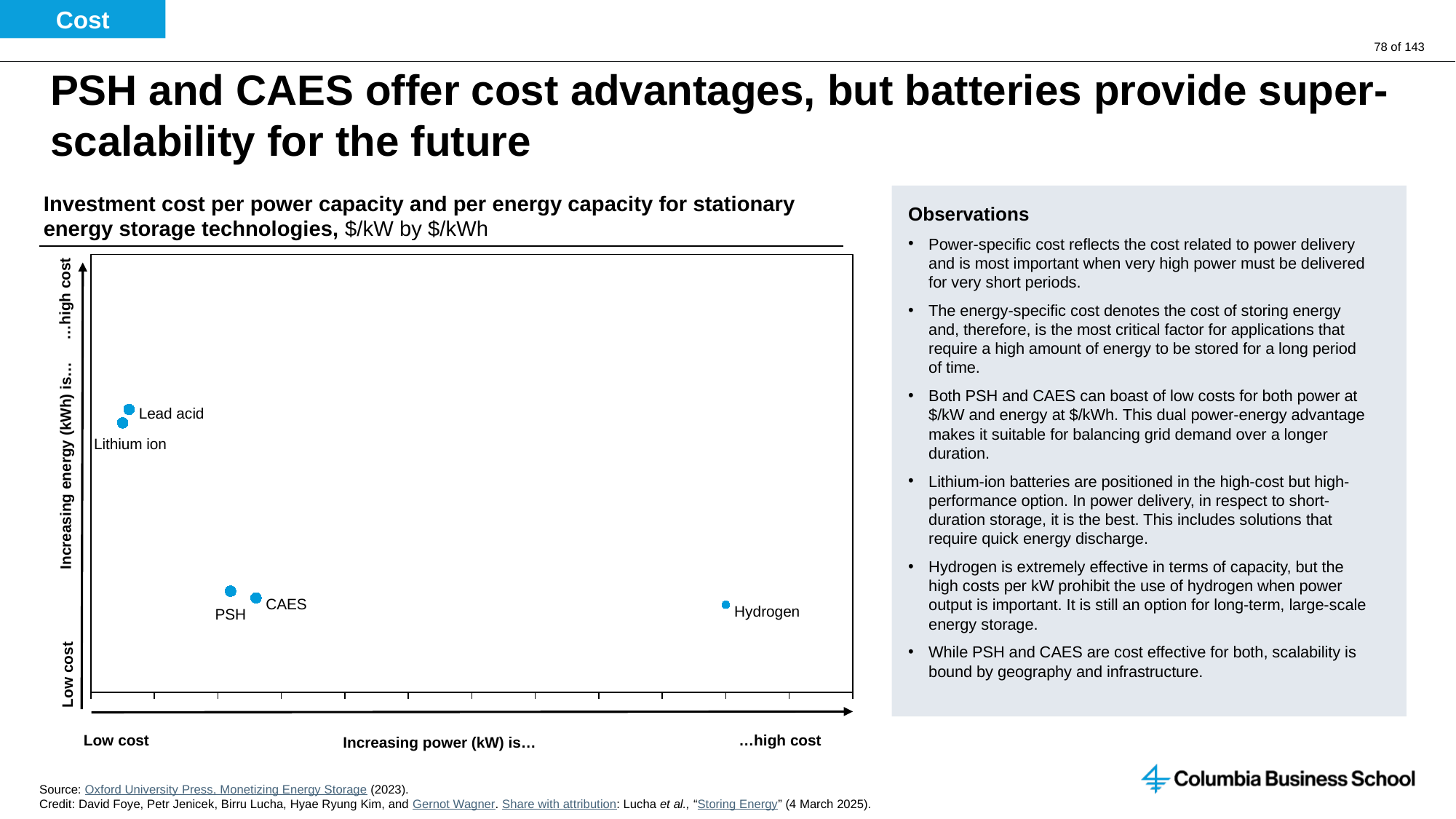
How many storage technologies are plotted on the chart? 5 Which technology is plotted furthest to the left, i.e. has the lowest power cost ($/kW)? Lithium ion Which has the higher energy cost ($/kWh) on the chart, Lithium ion or Hydrogen? Lithium ion Which has the higher power cost ($/kW) on the chart, Hydrogen or CAES? Hydrogen What quantity does the horizontal axis of the chart represent? Increasing power (kW) cost What units are given in the chart title for the two axes? $/kW by $/kWh Which has the higher energy cost ($/kWh) on the chart, Lead acid or PSH? Lead acid Which technology is plotted furthest to the right, i.e. has the highest power cost ($/kW)? Hydrogen Which technology is plotted highest on the vertical axis, i.e. has the highest energy cost ($/kWh)? Lead acid What kind of chart is shown on the slide? Scatter chart